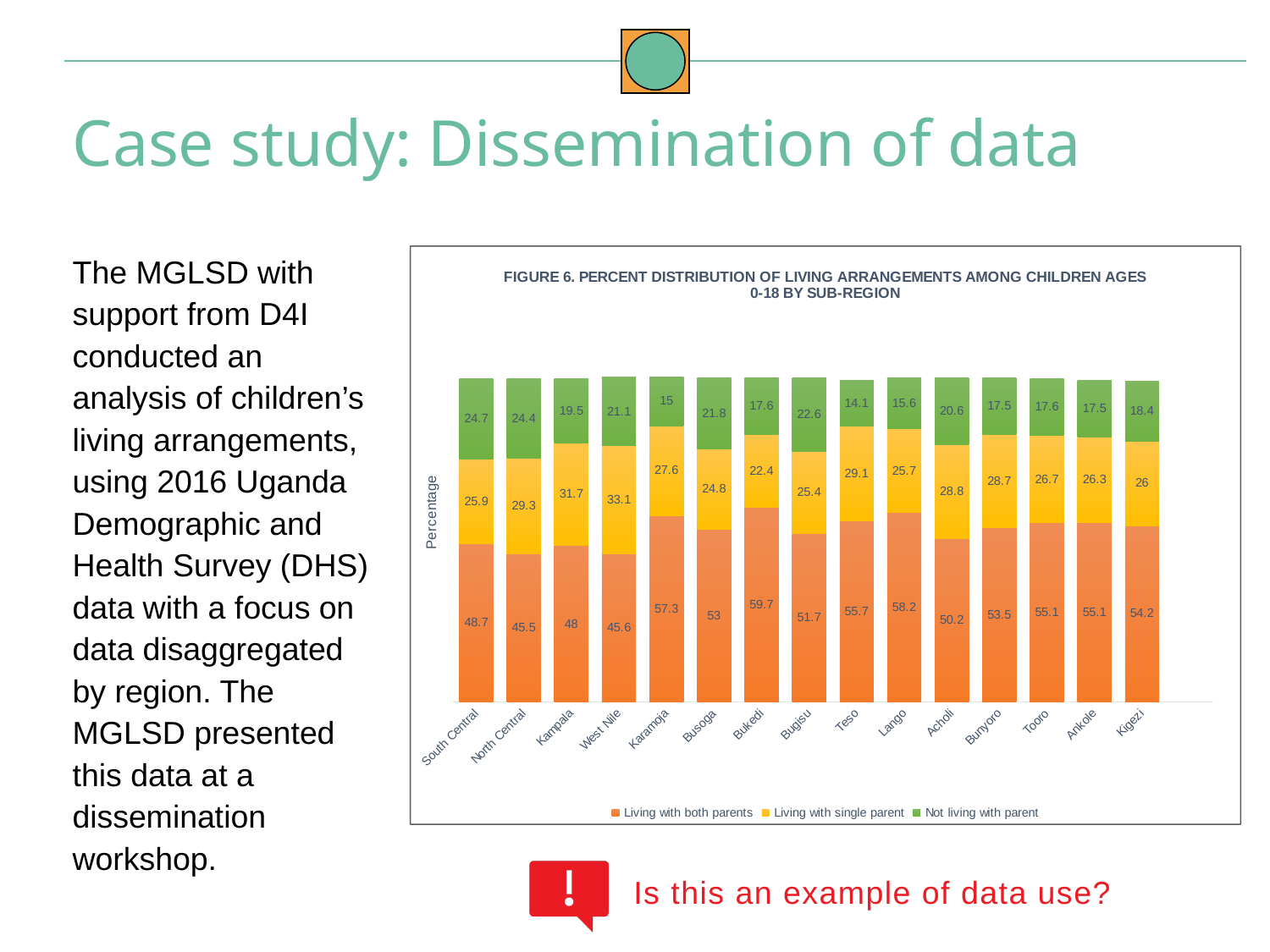
What is the value for 'Living with both parents' in Bukedi? 59.7 Which sub-region has the lowest value for 'Living with both parents'? North Central How many sub-regions are shown on the x axis of the chart? 15 Which sub-region has the highest value for 'Living with both parents'? Bukedi What is the value for 'Living with single parent' in West Nile? 33.1 What is the difference between the 'Living with both parents' values for Bukedi and North Central? 14.2 What is the total of the stacked bar for Karamoja? 99.9 What is the value for 'Not living with parent' in Teso? 14.1 Which sub-region has the highest value for 'Not living with parent'? South Central How many series does the chart's legend list? 3 Which is larger: the 'Living with single parent' value for Kampala or for Busoga? Kampala What type of chart is shown on the slide? Stacked bar chart